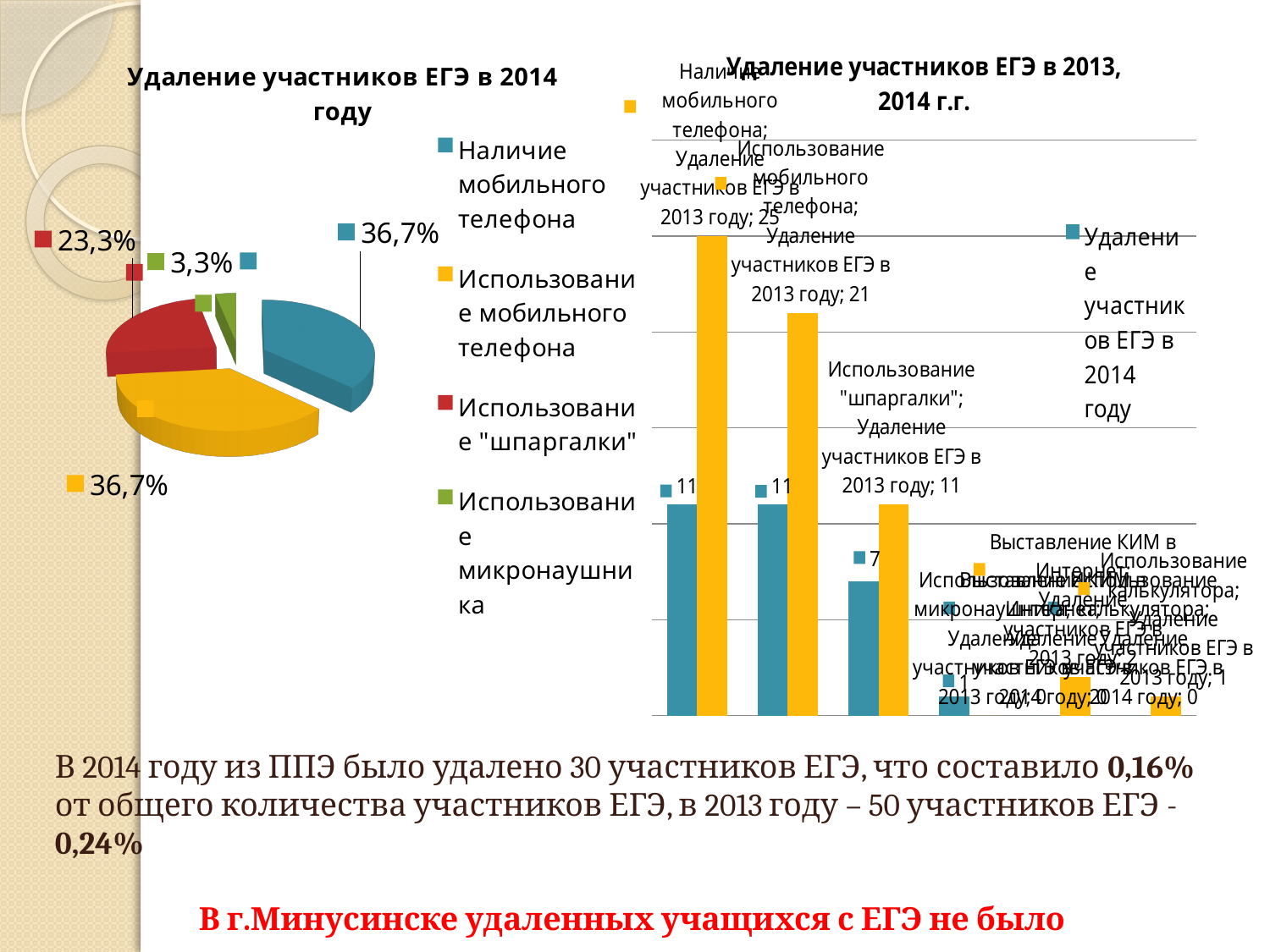
In the bar chart 'Удаление участников ЕГЭ в 2013, 2014 г.г.', what is the difference between the 2013 and 2014 values for 'Наличие мобильного телефона'? 14 In the bar chart 'Удаление участников ЕГЭ в 2013, 2014 г.г.', what is the value for 'Наличие мобильного телефона' in 2013? 25 What type of chart is the left chart 'Удаление участников ЕГЭ в 2014 году'? Pie chart In the pie chart 'Удаление участников ЕГЭ в 2014 году', what is the difference between the share for 'Использование "шпаргалки"' and the share for 'Использование микронаушника'? 20 percentage points In the pie chart 'Удаление участников ЕГЭ в 2014 году', what share is shown for 'Использование "шпаргалки"'? 23,3% What type of chart is the right chart 'Удаление участников ЕГЭ в 2013, 2014 г.г.'? Bar chart In the pie chart 'Удаление участников ЕГЭ в 2014 году', which category has the smallest slice? Использование микронаушника In the bar chart 'Удаление участников ЕГЭ в 2013, 2014 г.г.', what is the value for 'Использование "шпаргалки"' in 2014? 7 In the pie chart 'Удаление участников ЕГЭ в 2014 году', what share is shown for 'Использование микронаушника'? 3,3% How many categories does the legend of the pie chart 'Удаление участников ЕГЭ в 2014 году' list? 4 In the bar chart 'Удаление участников ЕГЭ в 2013, 2014 г.г.', what is the value for 'Использование мобильного телефона' in 2013? 21 In the bar chart 'Удаление участников ЕГЭ в 2013, 2014 г.г.', which is larger for 'Наличие мобильного телефона': the 2013 value or the 2014 value? 2013